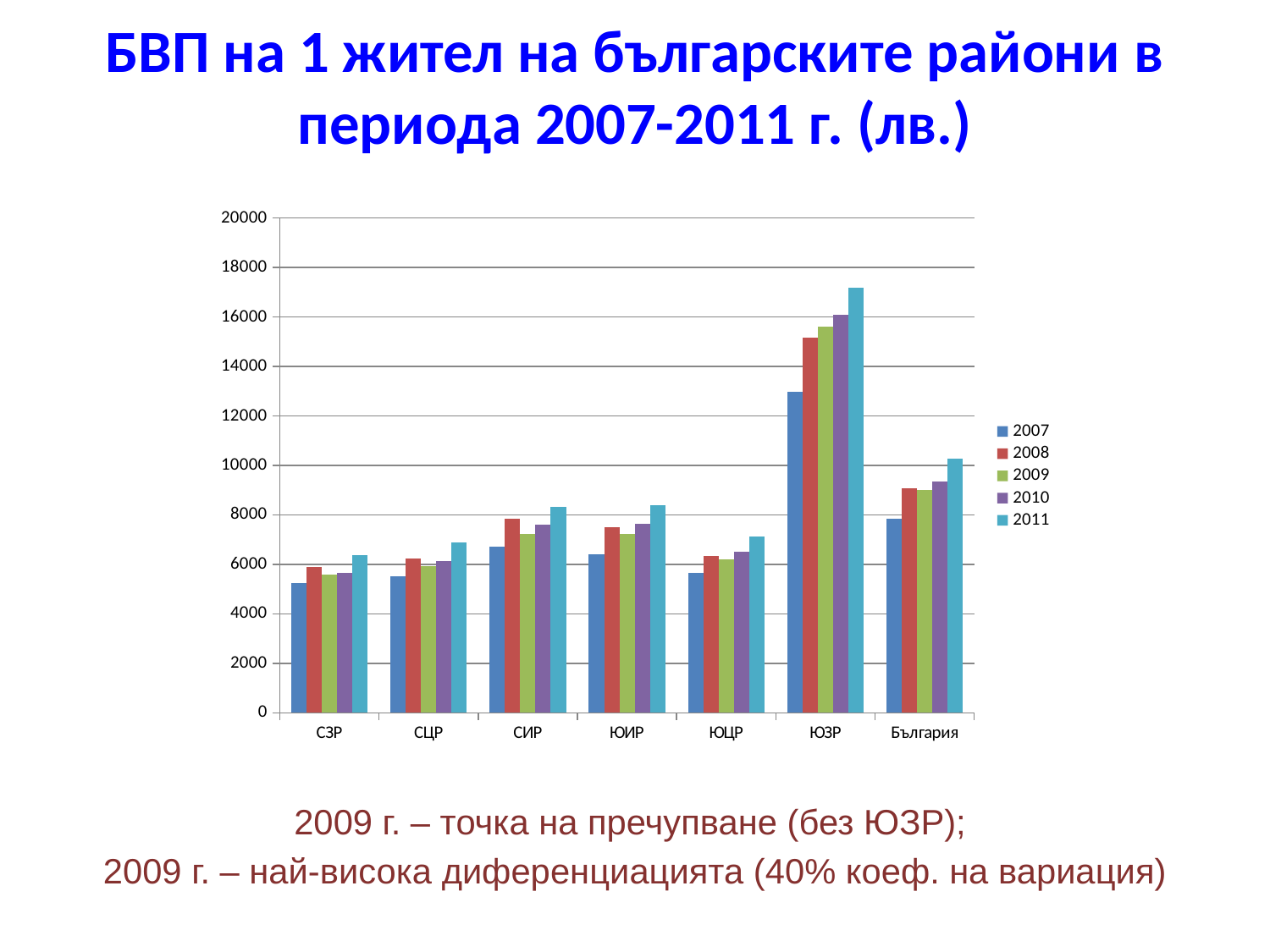
How many categories (regions) are shown on the x axis of the chart? 7 Which is larger: the 2007 value for ЮЗР or the 2011 value for България? ЮЗР in 2007 What kind of chart is shown on the slide? Bar chart Is the value for България in 2011 greater or less than 10000? greater Is the value for ЮЗР in 2011 greater or less than 16000? greater What are the entries listed in the chart's legend? 2007, 2008, 2009, 2010, 2011 How many series does the chart's legend list? 5 Which category has the lowest value for 2007? СЗР Is the value for СЗР in 2007 greater or less than 6000? less Which category has the highest value for 2011? ЮЗР Which is larger: the 2011 value for СИР or the 2011 value for ЮЦР? СИР Do the values for ЮЗР rise or fall from 2007 to 2011? rise